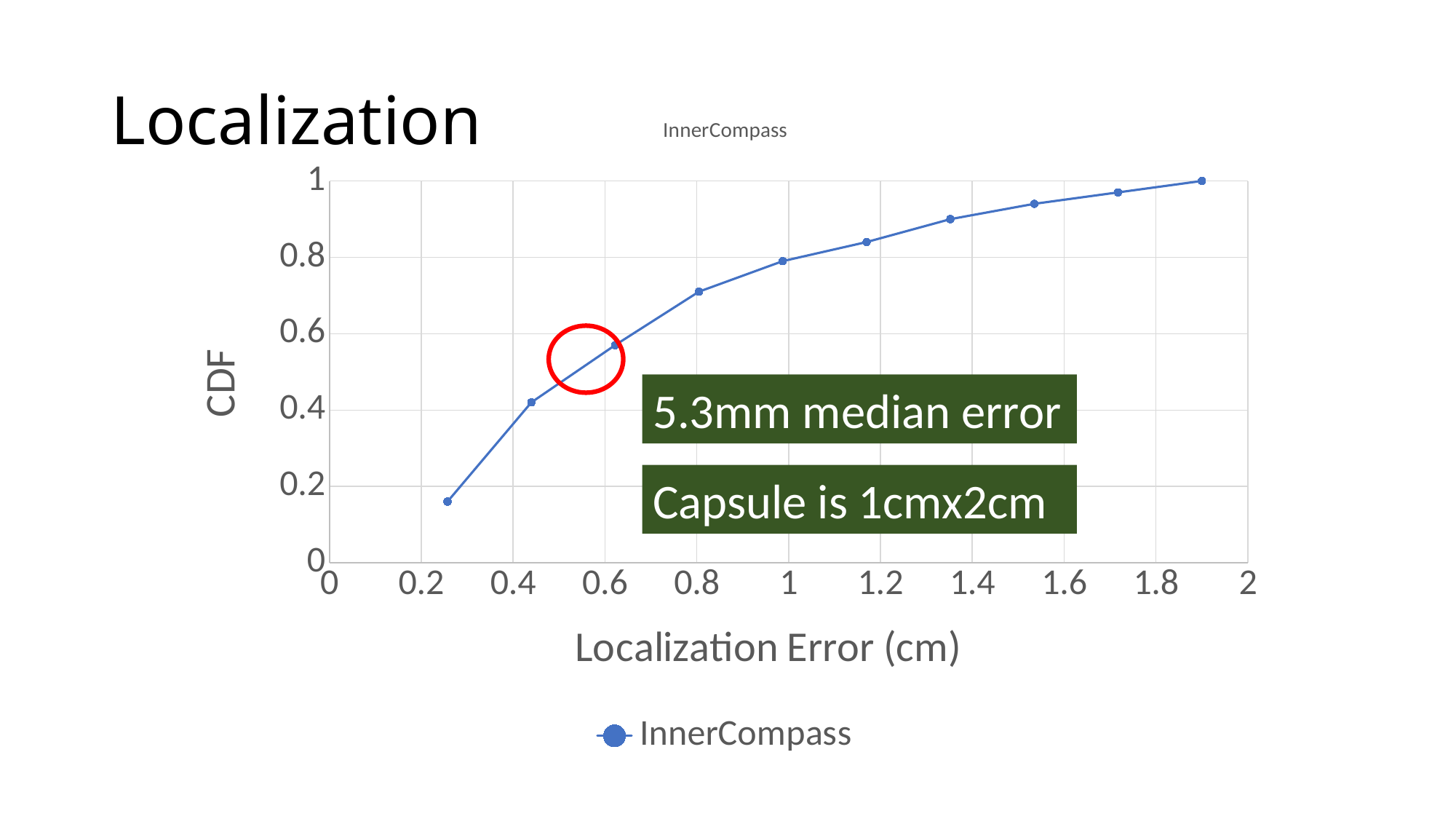
What CDF value does the rightmost point of the curve reach? 1 Is the CDF value at a localization error of about 1.35 cm greater or less than 0.8? greater Which has the higher CDF value: the point near 0.44 cm or the point near 1.17 cm? the point near 1.17 cm How many data points are plotted on the InnerCompass line? 10 What is the title of the chart? InnerCompass What kind of chart is shown on the slide? line chart Is the CDF value at a localization error of about 0.8 cm greater or less than 0.6? greater What is the label of the x axis? Localization Error (cm) How many series does the legend list? 1 Does the CDF rise or fall as Localization Error increases along the x axis? rise Is the CDF value of the leftmost point (near 0.26 cm) greater or less than 0.2? less What is the highest value shown on the y axis (CDF)? 1